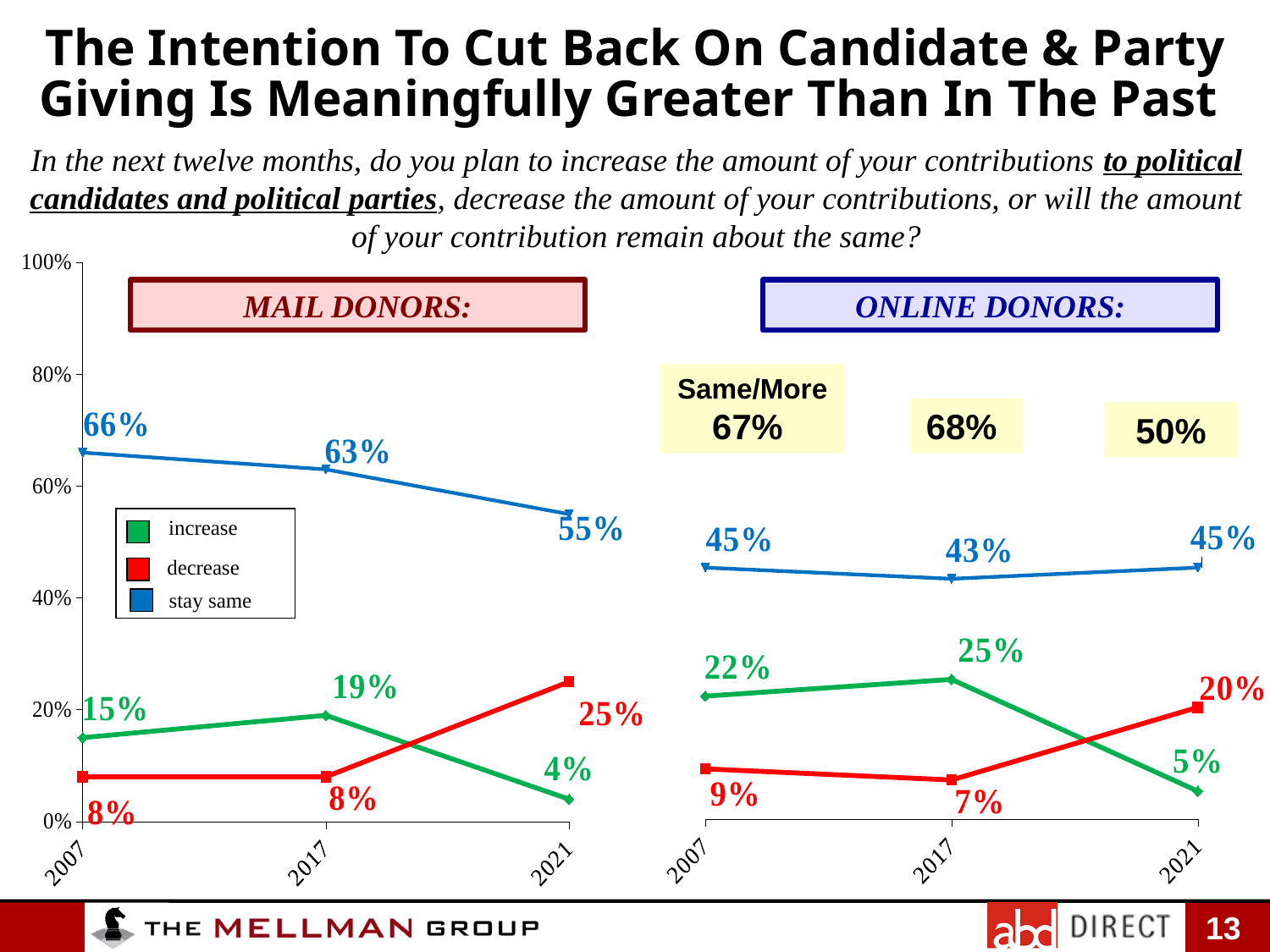
In the Mail Donors chart, what percentage said they would stay the same in 2007? 66% In the Online Donors chart, what is the Same/More value shown for 2021? 50% In the Online Donors chart, in which year was the 'decrease' value highest? 2021 In the Online Donors chart, what percentage said they would decrease in 2007? 9% What kind of chart is used for the Mail Donors data? line chart In the Mail Donors chart, does the 'stay same' line rise or fall from 2007 to 2021? fall In the Mail Donors chart, what percentage said they would decrease in 2021? 25% How many series does the legend list? 3 In the Mail Donors chart, in which year was the 'increase' value lowest? 2021 In the Online Donors chart, what percentage said they would increase in 2017? 25% In the Mail Donors chart, what is the difference between the 'stay same' values for 2007 and 2021? 11% In the Online Donors chart, which is larger in 2021: the 'decrease' value or the 'increase' value? decrease